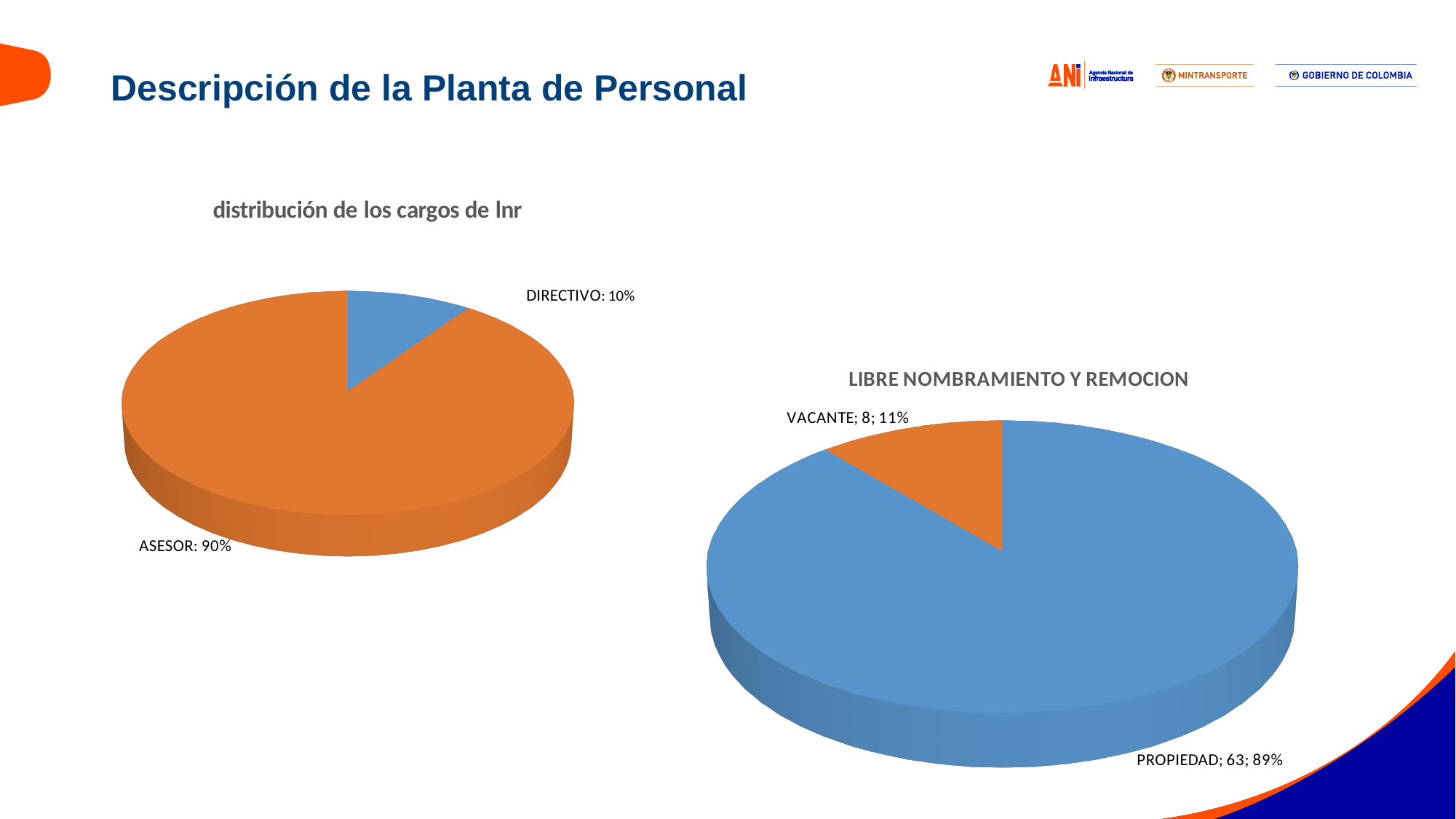
In the 'distribución de los cargos de lnr' chart, what share does ASESOR have? 90% In the 'LIBRE NOMBRAMIENTO Y REMOCION' chart, what share does PROPIEDAD have? 89% In the 'LIBRE NOMBRAMIENTO Y REMOCION' chart, what is the value for VACANTE? 8 In the 'LIBRE NOMBRAMIENTO Y REMOCION' chart, what share does VACANTE have? 11% In the 'distribución de los cargos de lnr' chart, which category has the largest slice? ASESOR In the 'LIBRE NOMBRAMIENTO Y REMOCION' chart, what is the difference between the PROPIEDAD and VACANTE values? 55 What kind of chart is the 'distribución de los cargos de lnr' chart? Pie chart In the 'LIBRE NOMBRAMIENTO Y REMOCION' chart, what is the value for PROPIEDAD? 63 In the 'distribución de los cargos de lnr' chart, how many slices does the pie have? 2 In the 'LIBRE NOMBRAMIENTO Y REMOCION' chart, what colour is the PROPIEDAD slice? Blue In the 'LIBRE NOMBRAMIENTO Y REMOCION' chart, which category has the smallest slice? VACANTE